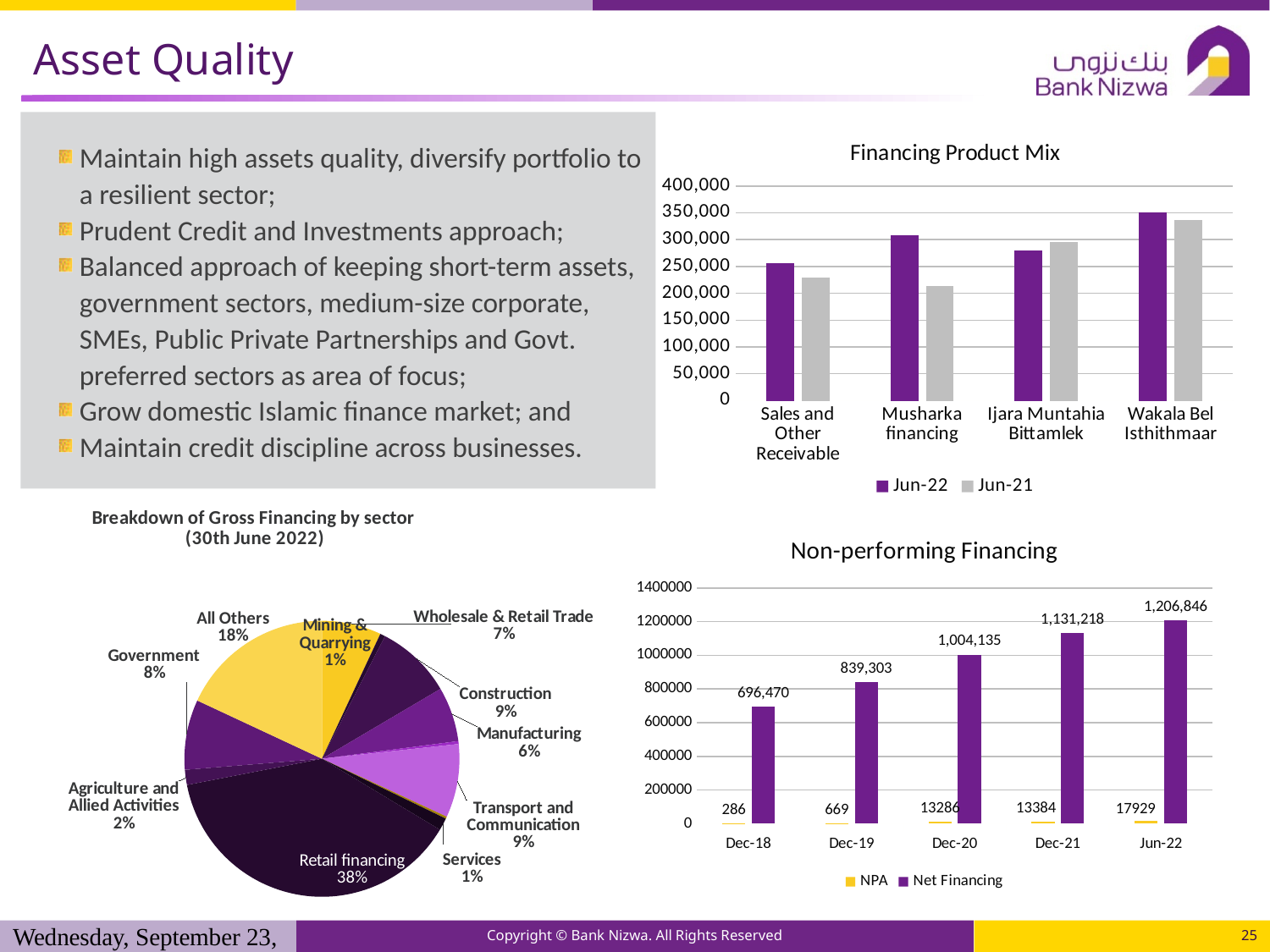
In the Non-performing Financing chart, how many periods are shown on the x axis? 5 In the Financing Product Mix chart, how many series does the legend list? 2 In the Breakdown of Gross Financing by sector pie chart, what share does Retail financing have? 38% In the Non-performing Financing chart, what is the difference in Net Financing between Dec-21 and Dec-20? 127,083 In the Non-performing Financing chart, what is the Net Financing value for Jun-22? 1,206,846 In the Non-performing Financing chart, which period has the lowest Net Financing? Dec-18 In the Non-performing Financing chart, does Net Financing rise or fall from Dec-18 to Jun-22? rise In the Financing Product Mix chart, which product has the highest Jun-22 value? Wakala Bel Isthithmaar In the Breakdown of Gross Financing by sector pie chart, which sector has the largest share? Retail financing In the Financing Product Mix chart, is the Jun-22 value for Musharka financing greater or less than 250,000? greater In the Non-performing Financing chart, what is the NPA value for Dec-20? 13286